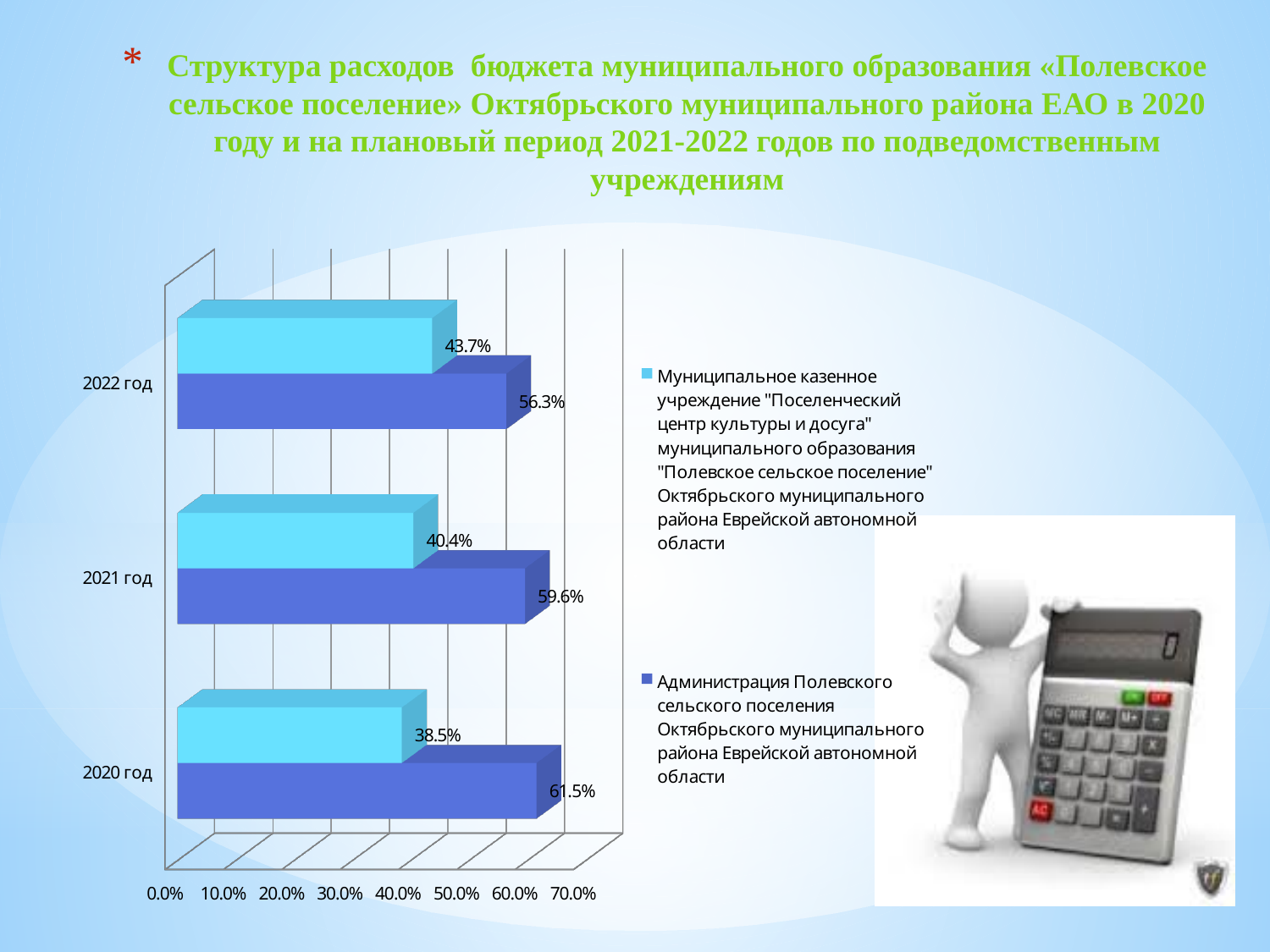
In which year is the share of Администрация Полевского сельского поселения the highest? 2020 год Which series has the larger value in 2022 год? Администрация Полевского сельского поселения How many series does the legend list? 2 What is the value for Администрация Полевского сельского поселения in 2020 год? 61.5% What is the value for Администрация Полевского сельского поселения in 2022 год? 56.3% Does the share of Муниципальное казенное учреждение "Поселенческий центр культуры и досуга" rise or fall from 2020 год to 2022 год? rise What is the value for Муниципальное казенное учреждение "Поселенческий центр культуры и досуга" in 2021 год? 40.4% What is the value for Муниципальное казенное учреждение "Поселенческий центр культуры и досуга" in 2022 год? 43.7% What kind of chart is shown on the slide? bar chart How many year categories does the chart show? 3 What is the difference between the two series' values in 2021 год? 19.2% In which year is the share of Муниципальное казенное учреждение "Поселенческий центр культуры и досуга" the lowest? 2020 год